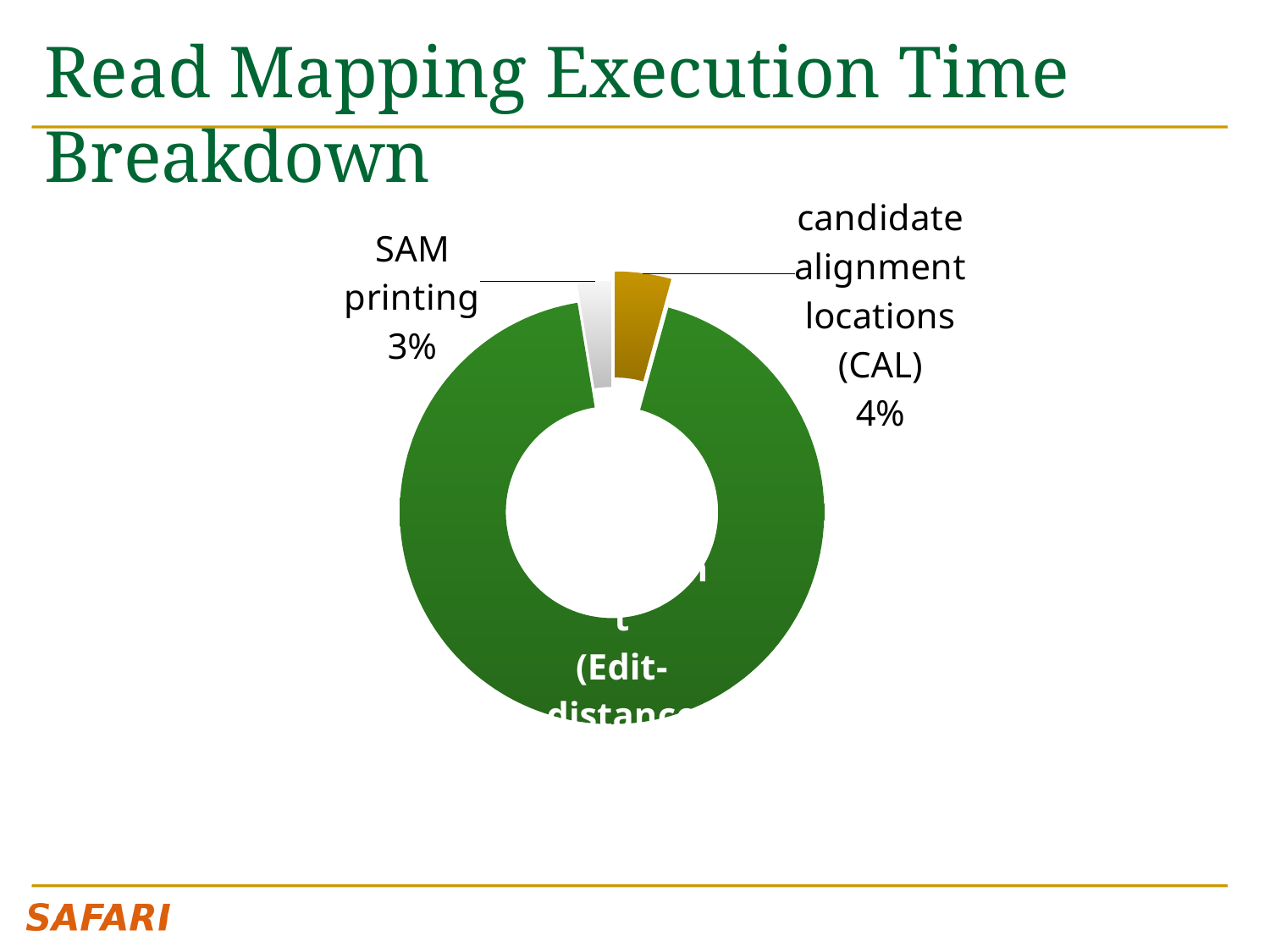
What percentage of execution time is attributed to candidate alignment locations (CAL)? 4% What percentage of read mapping execution time is spent on SAM printing? 3% By how many percentage points does the CAL share exceed the SAM printing share? 1% Which takes a larger share of execution time, SAM printing or candidate alignment locations (CAL)? candidate alignment locations (CAL) Which labelled category has the smallest share of execution time? SAM printing How many slices does the chart contain? 3 What kind of chart is shown on the slide? doughnut chart What colour is the slice representing candidate alignment locations (CAL)? gold What is the title of the slide containing the chart? Read Mapping Execution Time Breakdown